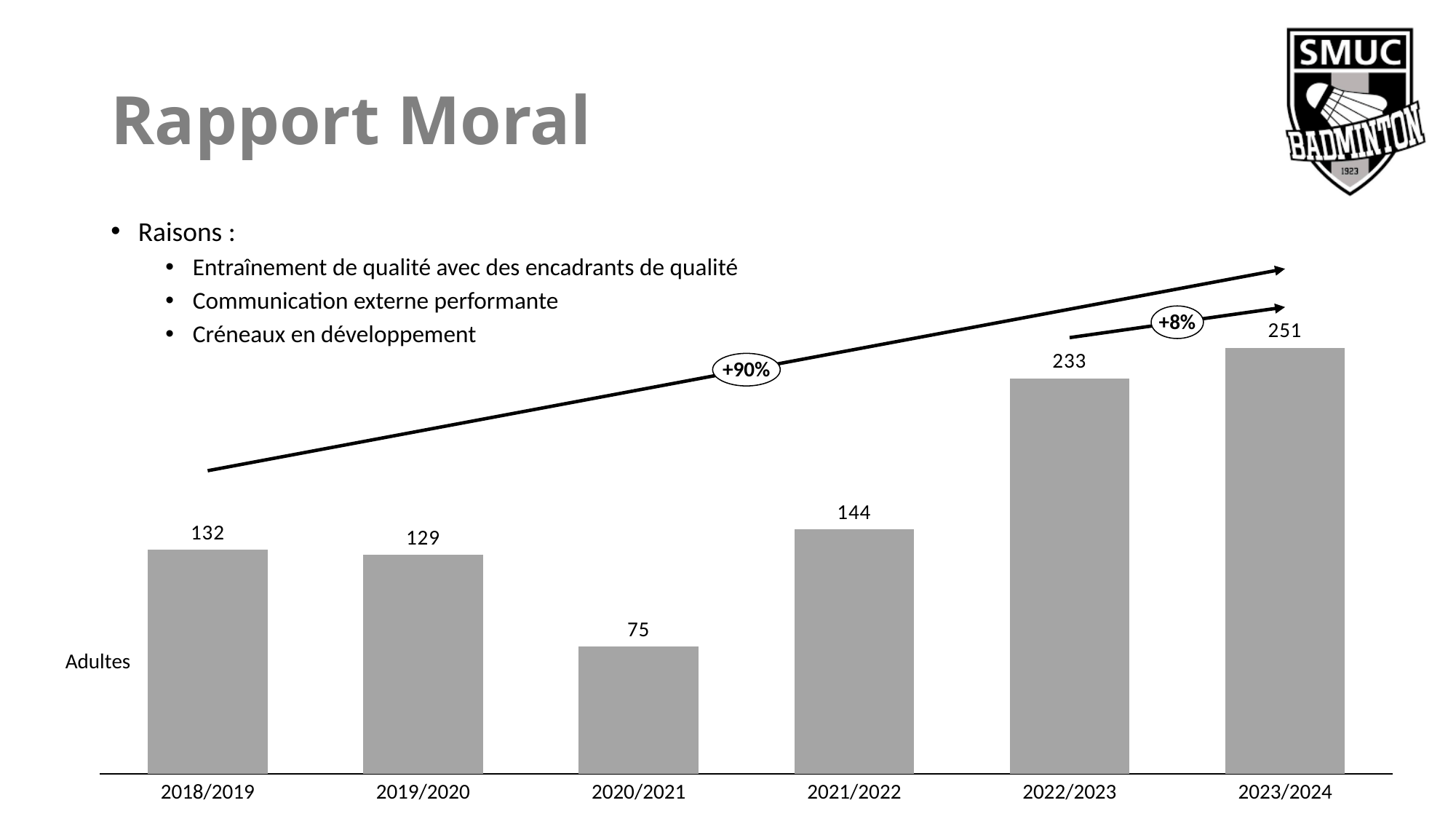
Do the values rise or fall from 2020/2021 to 2023/2024? rise Which season has the highest value? 2023/2024 Which season has the lowest value? 2020/2021 What is the difference between the values for 2023/2024 and 2022/2023? 18 What is the value for 2023/2024? 251 Which is larger, the value for 2018/2019 or the value for 2019/2020? 2018/2019 How many seasons are shown on the chart? 6 What is the value for 2020/2021? 75 What is the value for 2018/2019? 132 What is the difference between the values for 2021/2022 and 2020/2021? 69 What label is shown on the left of the chart next to the bars? Adultes What kind of chart is shown on the slide? bar chart